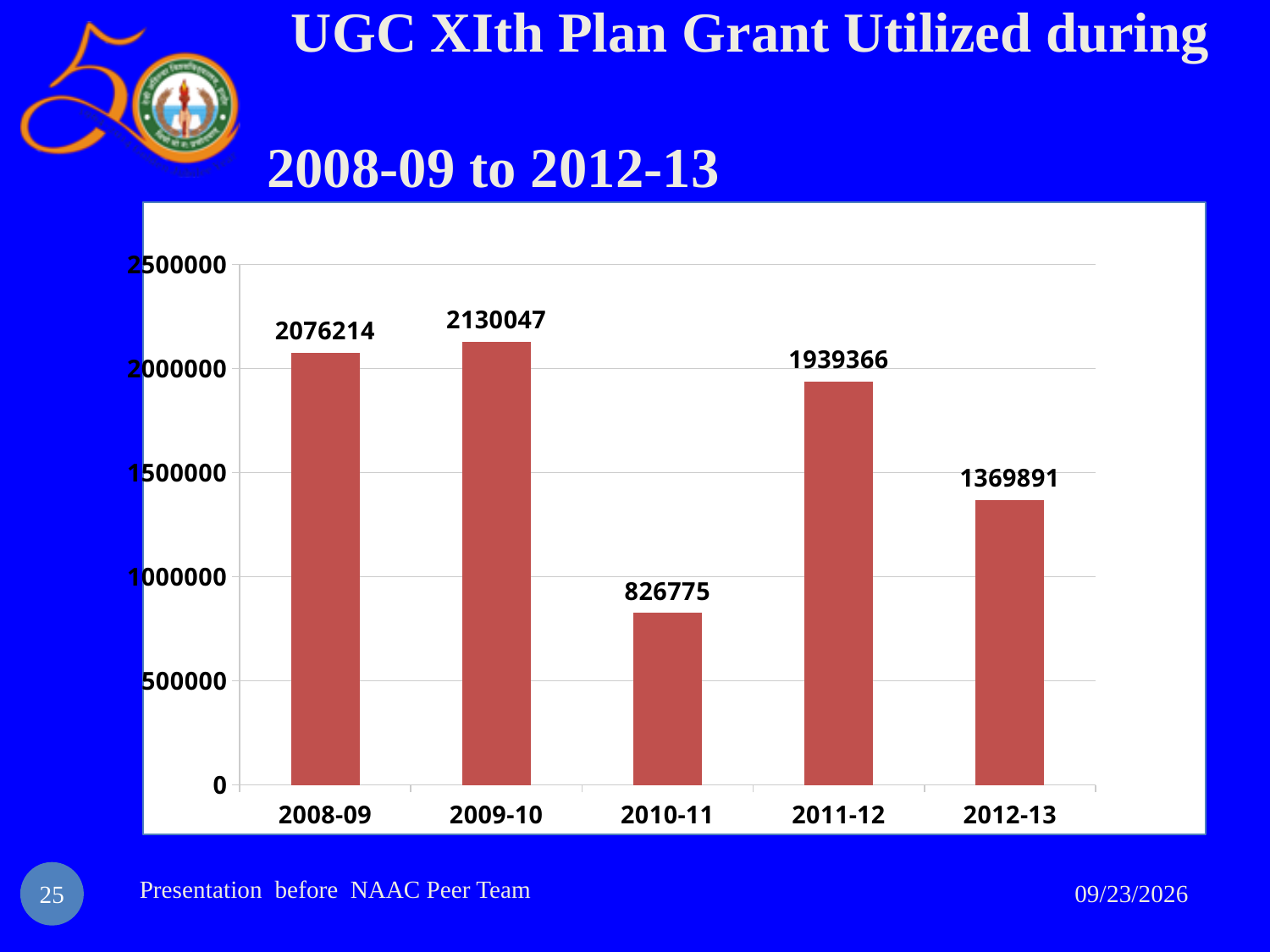
What value is shown for 2008-09? 2076214 Which is larger, the value for 2011-12 or the value for 2012-13? 2011-12 Is the value for 2010-11 greater or less than 1000000? less What value is shown for 2012-13? 1369891 Does the grant utilized rise or fall from 2011-12 to 2012-13? fall What was the UGC XIth Plan grant utilized in 2010-11? 826775 What is the difference between the values for 2011-12 and 2012-13? 569475 What kind of chart is shown on the slide? bar chart What is the difference between the values for 2009-10 and 2008-09? 53833 How many years are shown on the x axis? 5 Which year has the highest grant utilized? 2009-10 Which year has the lowest grant utilized? 2010-11